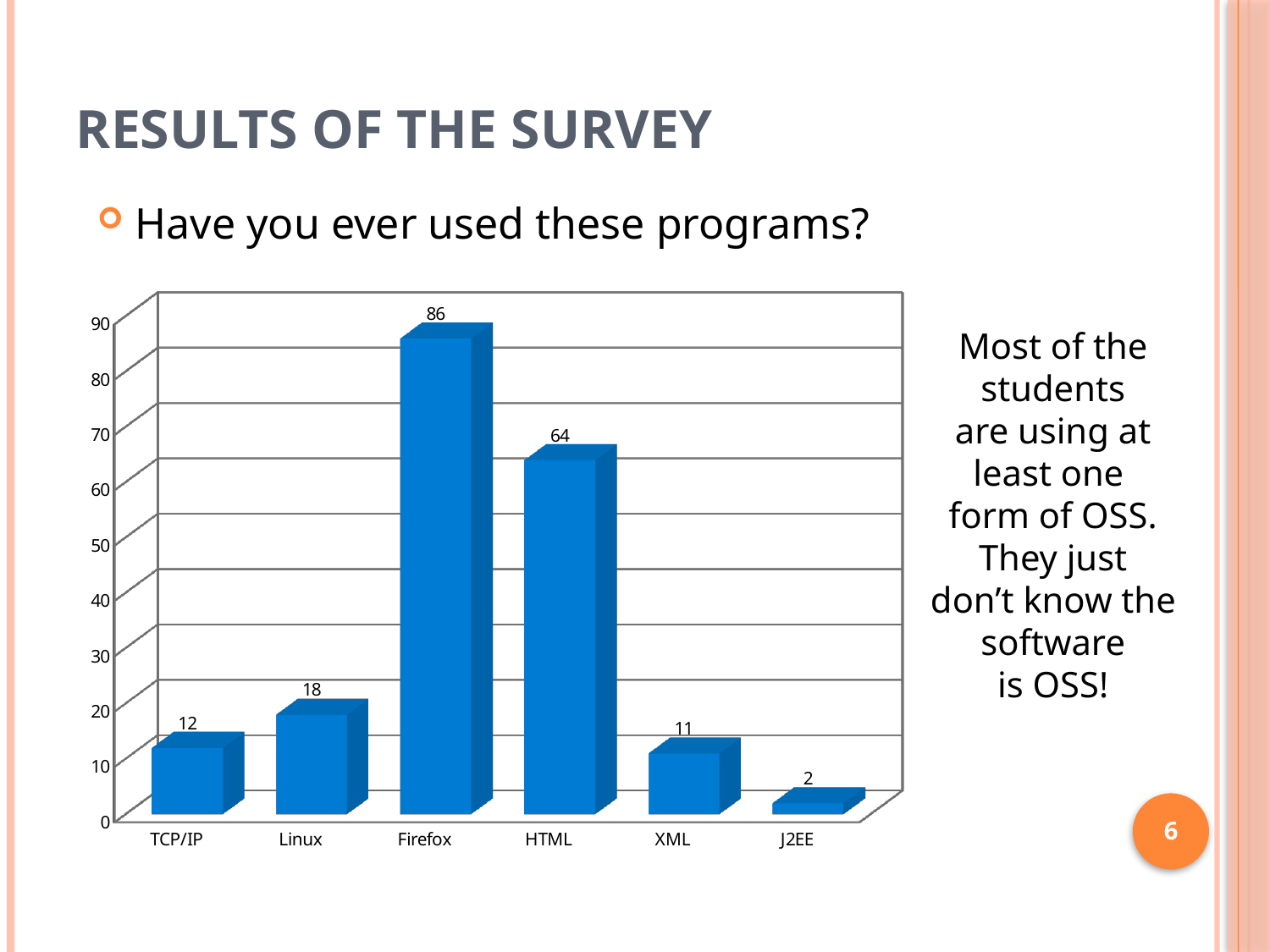
Is the value for HTML greater or less than 60? greater What is the value for Linux? 18 Which program has the highest value? Firefox What is the value for HTML? 64 What is the value for Firefox? 86 Which is larger, the value for TCP/IP or the value for XML? TCP/IP Which program has the lowest value? J2EE How many programs are shown on the x axis? 6 What is the value for J2EE? 2 What kind of chart is shown on the slide? bar chart What is the difference between the values for Linux and TCP/IP? 6 What is the difference between the values for Firefox and HTML? 22